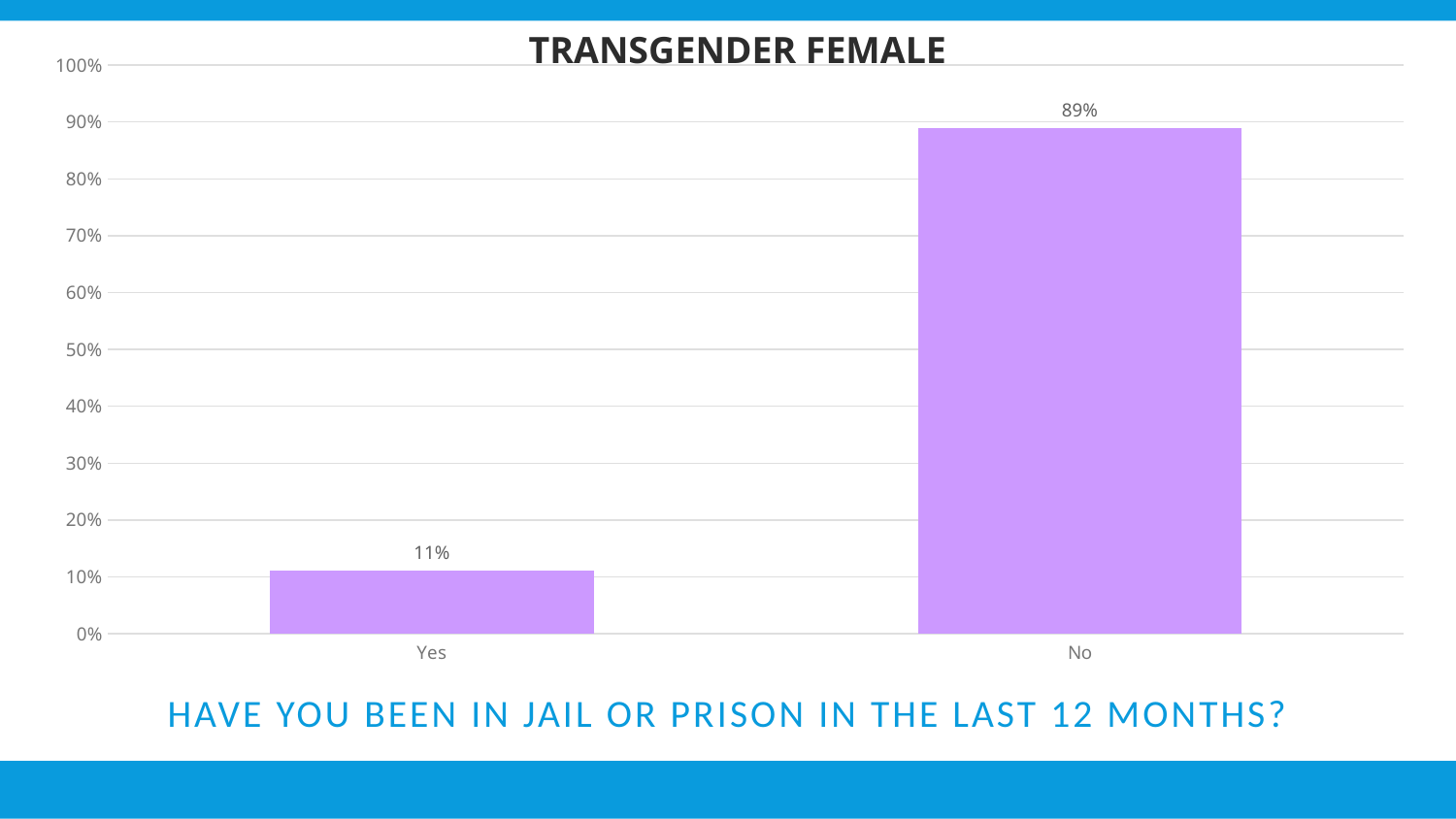
What is the value for No? 89% What is the difference between the values for No and Yes? 78% What kind of chart is shown on the slide? bar chart What is the value for Yes? 11% Is the value for No greater or less than 80%? greater How many categories are shown on the x axis? 2 What is the title of the chart? TRANSGENDER FEMALE Which category has the lowest value? Yes Which category has the highest value? No Which is larger, the value for Yes or the value for No? No What is the highest value shown on the y axis? 100% Is the value for Yes greater or less than 20%? less